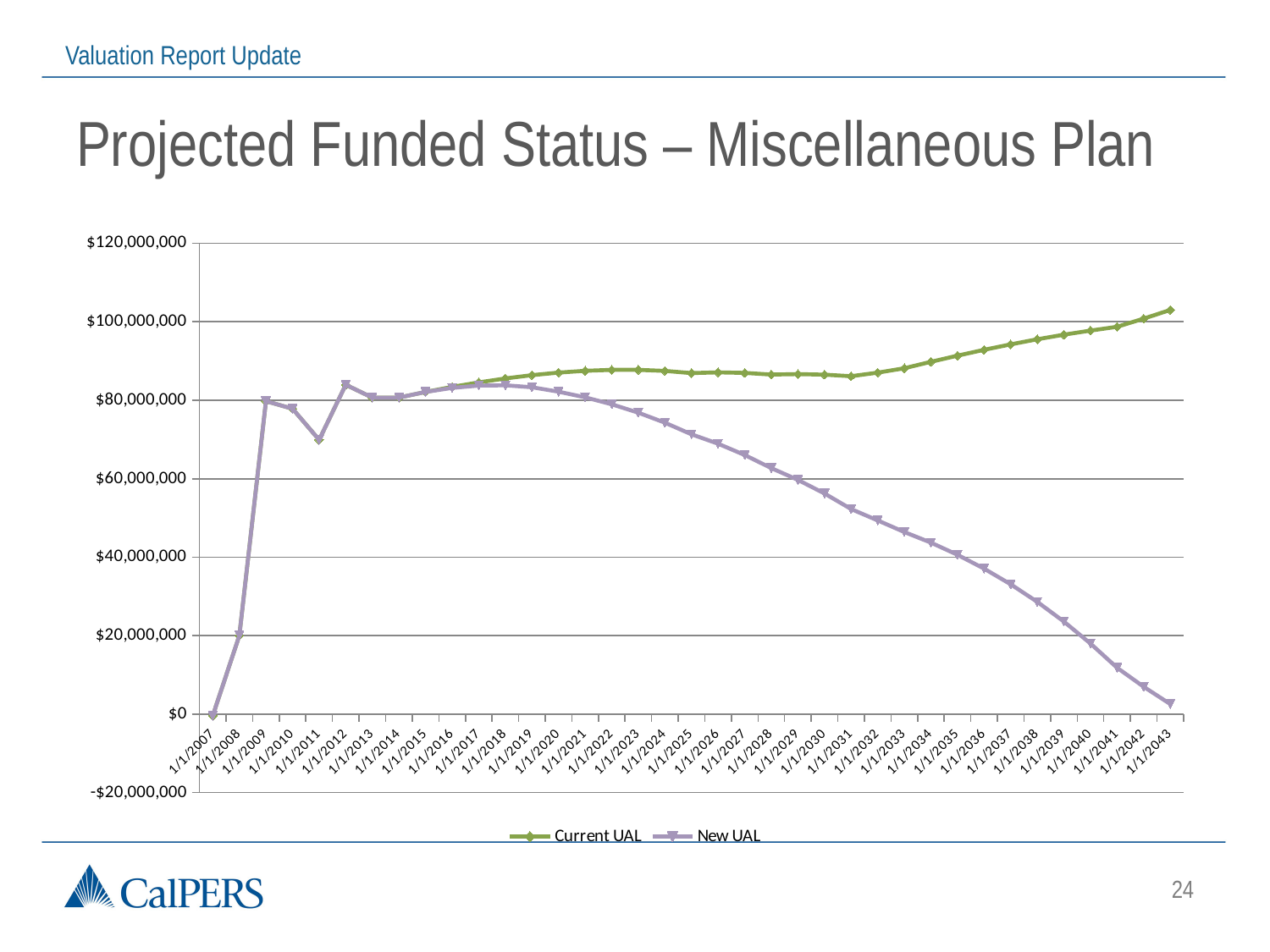
What colour is the New UAL line? Purple What are the two series named in the legend? Current UAL and New UAL Does the Current UAL series rise or fall from 1/1/2031 to 1/1/2043? Rise Does the New UAL series rise or fall from 1/1/2012 to 1/1/2043? Fall Is the New UAL value at 1/1/2035 greater or less than $60,000,000? less Is the Current UAL value at 1/1/2043 greater or less than $100,000,000? greater How many dates are shown along the x axis? 37 Is the New UAL value at 1/1/2043 greater or less than $20,000,000? less At 1/1/2040, which series has the larger value, Current UAL or New UAL? Current UAL How many series does the legend list? 2 What kind of chart is shown on the slide? Line chart